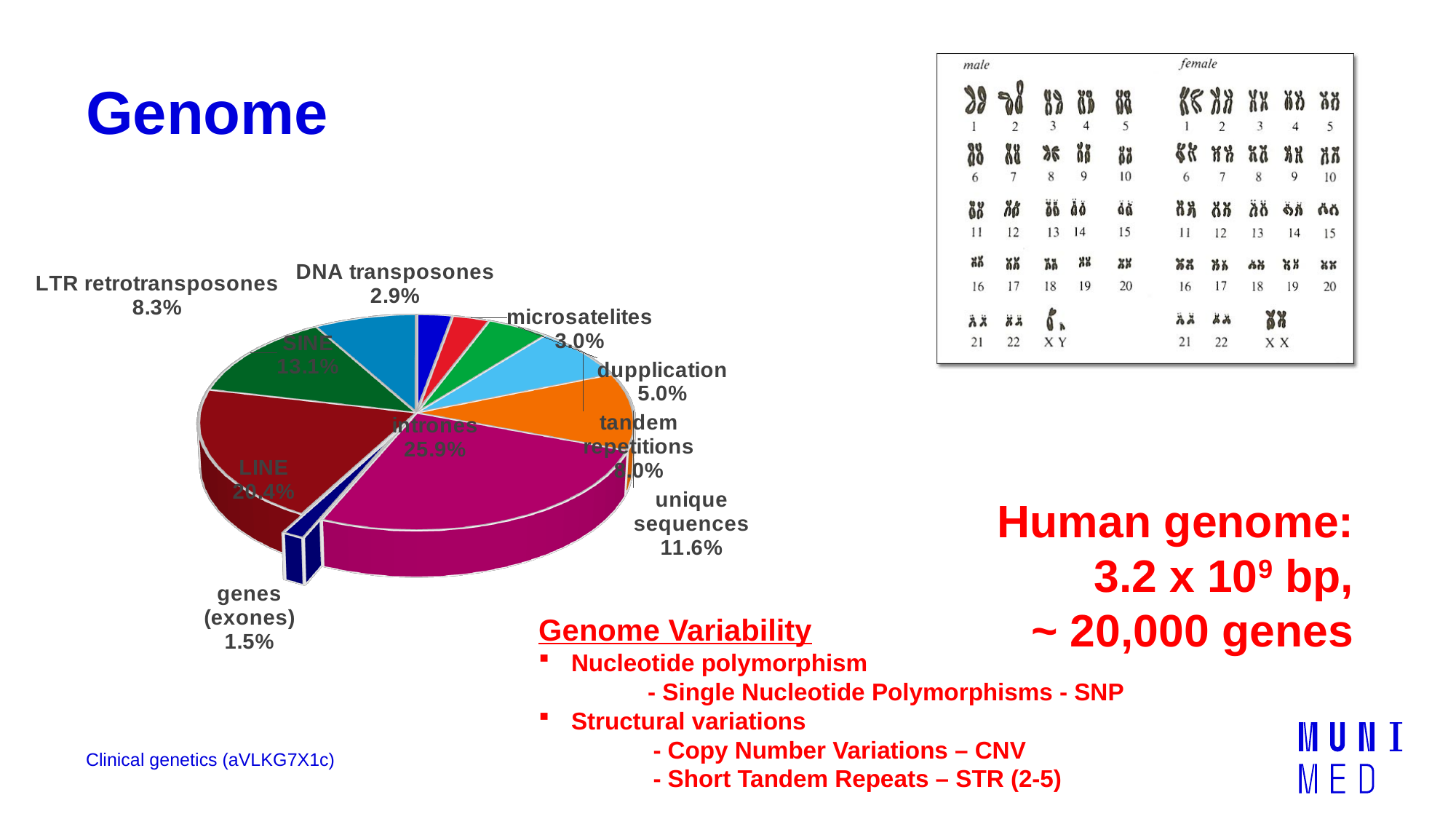
What percentage of the genome is shown for LTR retrotransposones? 8.3% What percentage is shown for introns? 25.9% Which has a larger share, dupplication or microsatelites? dupplication What percentage is shown for DNA transposones? 2.9% Which category has the largest share of the pie? intrones What percentage is shown for unique sequences? 11.6% What is the difference in percentage points between LINE and SINE? 7.3 Which category has the smallest share of the pie? genes (exones) How many slices does the pie chart have? 10 What percentage is shown for genes (exones)? 1.5% What kind of chart is shown on the slide? pie chart Which slice is pulled out (exploded) from the pie? genes (exones)